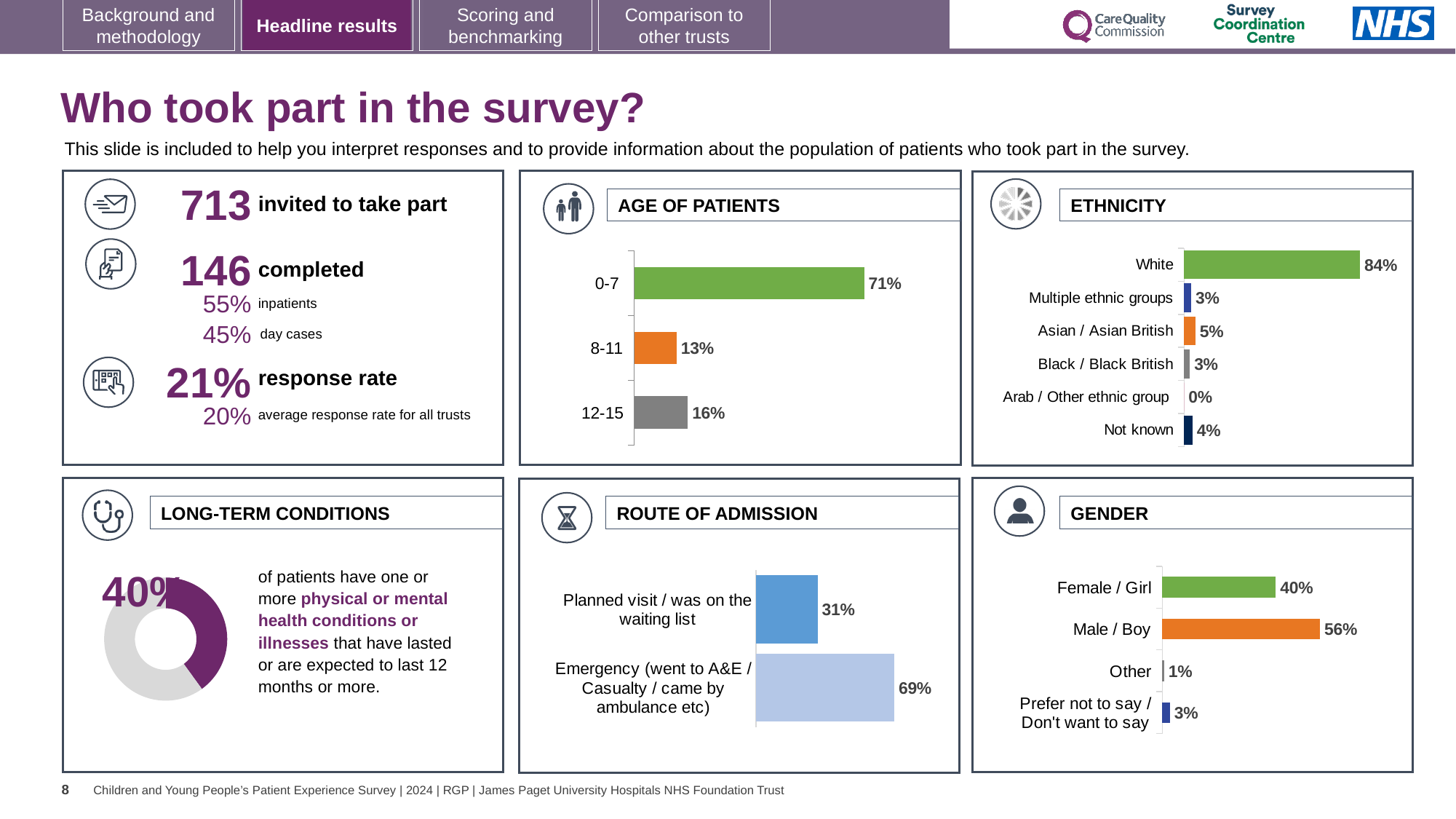
In the GENDER chart, which is larger, Female / Girl or Male / Boy? Male / Boy In the ETHNICITY chart, what percentage is shown for Asian / Asian British? 5% In the ETHNICITY chart, which category has the lowest percentage? Arab / Other ethnic group In the ROUTE OF ADMISSION chart, what is the difference between the Emergency and Planned visit percentages? 38% In the AGE OF PATIENTS chart, what is the difference between the 12-15 and 8-11 percentages? 3% How many ethnicity categories are shown in the ETHNICITY chart? 6 In the ETHNICITY chart, what percentage of patients were White? 84% In the AGE OF PATIENTS chart, what percentage of patients were aged 0-7? 71% In the AGE OF PATIENTS chart, which age group has the lowest percentage? 8-11 In the GENDER chart, what percentage is shown for Prefer not to say / Don't want to say? 3% What type of chart is used in the LONG-TERM CONDITIONS panel? Doughnut chart In the ROUTE OF ADMISSION chart, what percentage of patients came via Emergency (went to A&E / Casualty / came by ambulance etc)? 69%